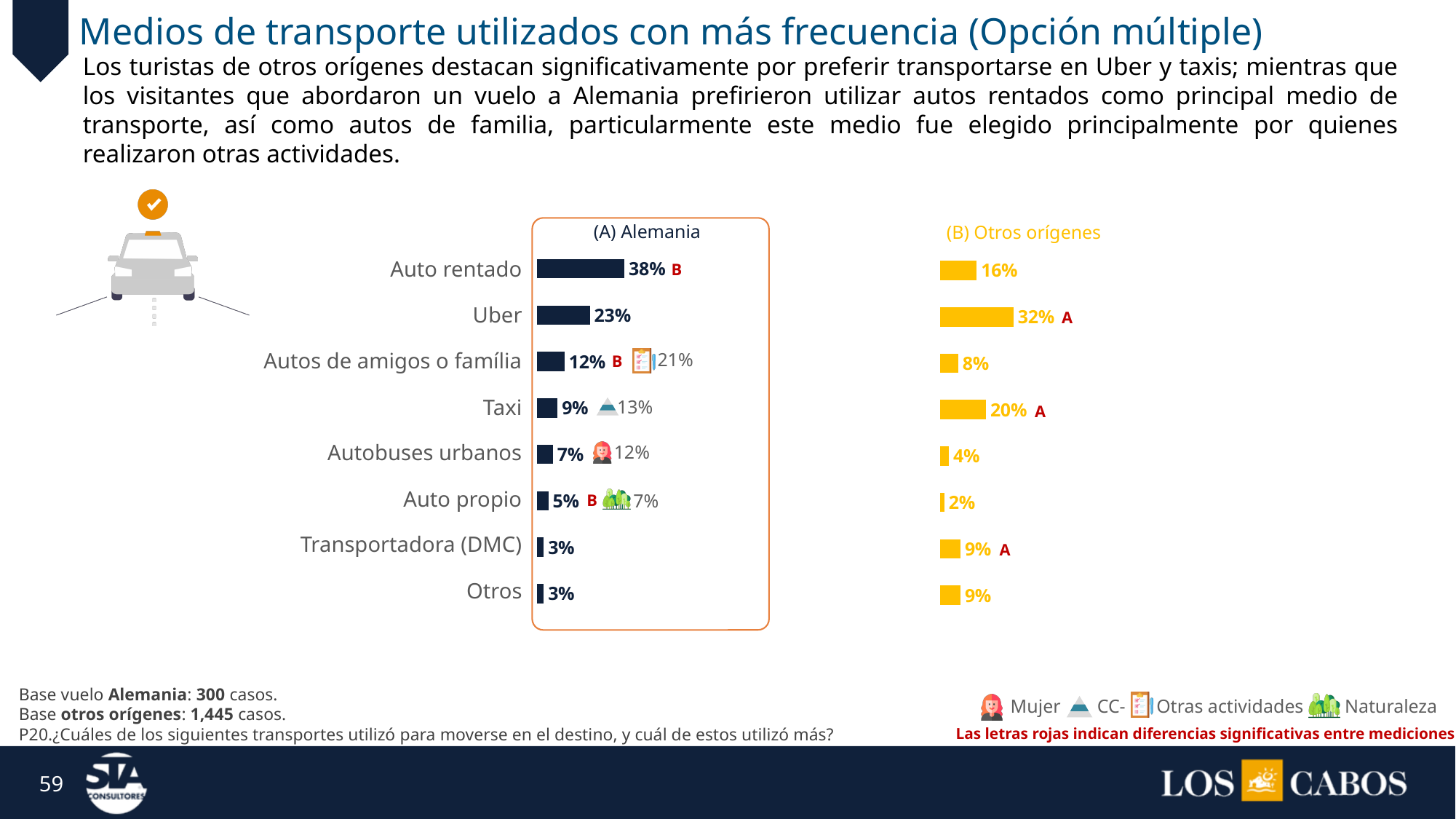
In the (B) Otros orígenes chart, what is the value for Taxi? 20% In the (A) Alemania chart, what is the difference between Auto rentado and Uber? 15 percentage points In the (B) Otros orígenes chart, what is the value for Uber? 32% In the (B) Otros orígenes chart, which category has the lowest value? Auto propio Which is larger for Taxi: the (A) Alemania value or the (B) Otros orígenes value? (B) Otros orígenes How many transport categories are shown in the (A) Alemania chart? 8 What kind of chart is used for (A) Alemania? Bar chart In the (A) Alemania chart, which category has the highest value? Auto rentado In the (A) Alemania chart, what is the value for Autobuses urbanos? 7% In the (B) Otros orígenes chart, which category has the highest value? Uber In the (B) Otros orígenes chart, what is the difference between Uber and Auto rentado? 16 percentage points In the (A) Alemania chart, what is the value for Auto rentado? 38%